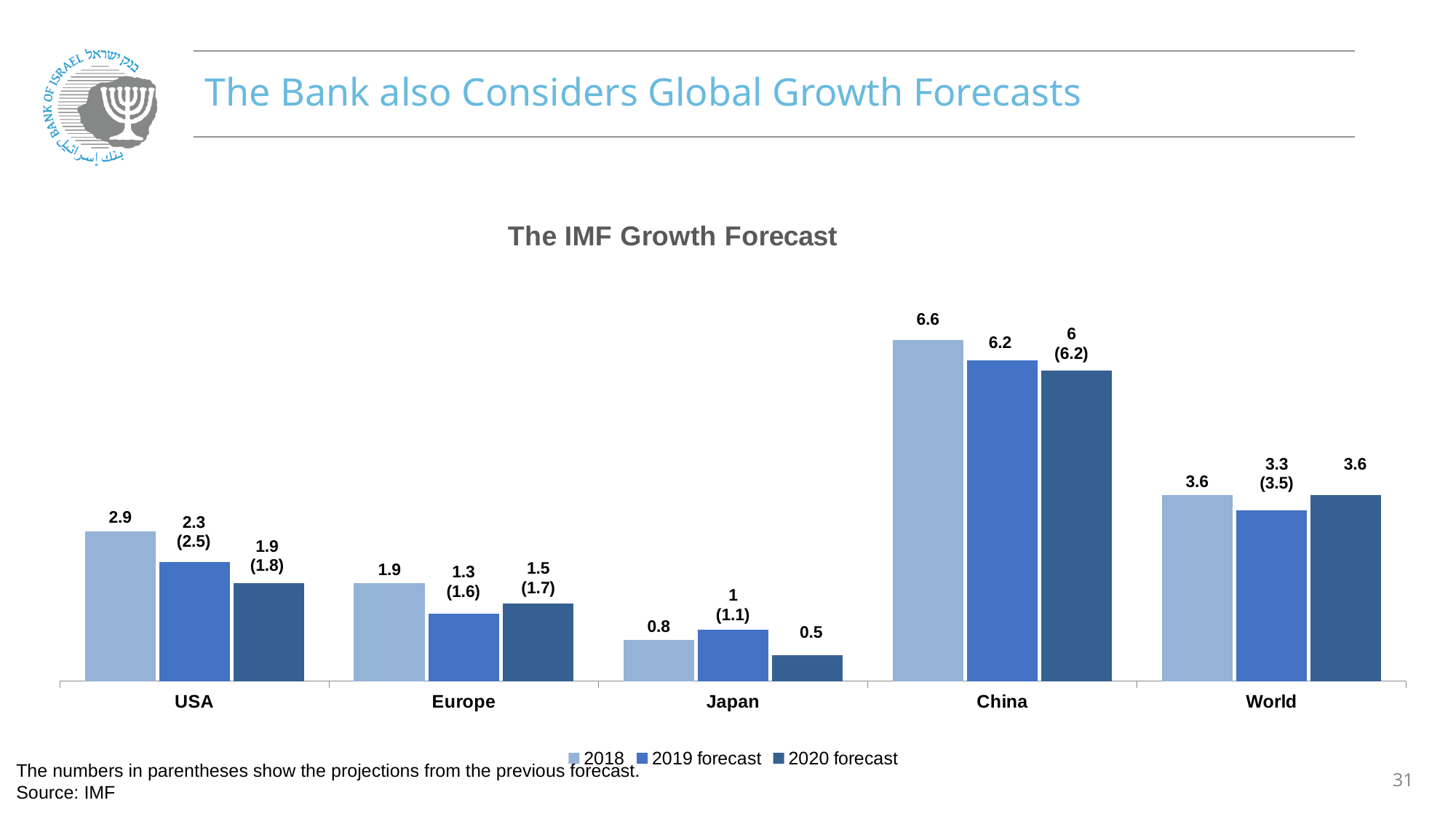
What is the 2019 forecast value for the USA? 2.3 Which category has the lowest 2020 forecast value? Japan How many categories are shown on the x axis? 5 Which is larger for Europe: the 2019 forecast or the 2020 forecast? 2020 forecast What is the 2020 forecast value for the World? 3.6 What is the title of the chart? The IMF Growth Forecast What is the 2020 forecast value for Japan? 0.5 What is the difference between the 2018 value and the 2020 forecast value for the USA? 1 Which category has the highest 2018 value? China How many series does the legend list? 3 What kind of chart is shown? Bar chart What is the 2018 value for China? 6.6